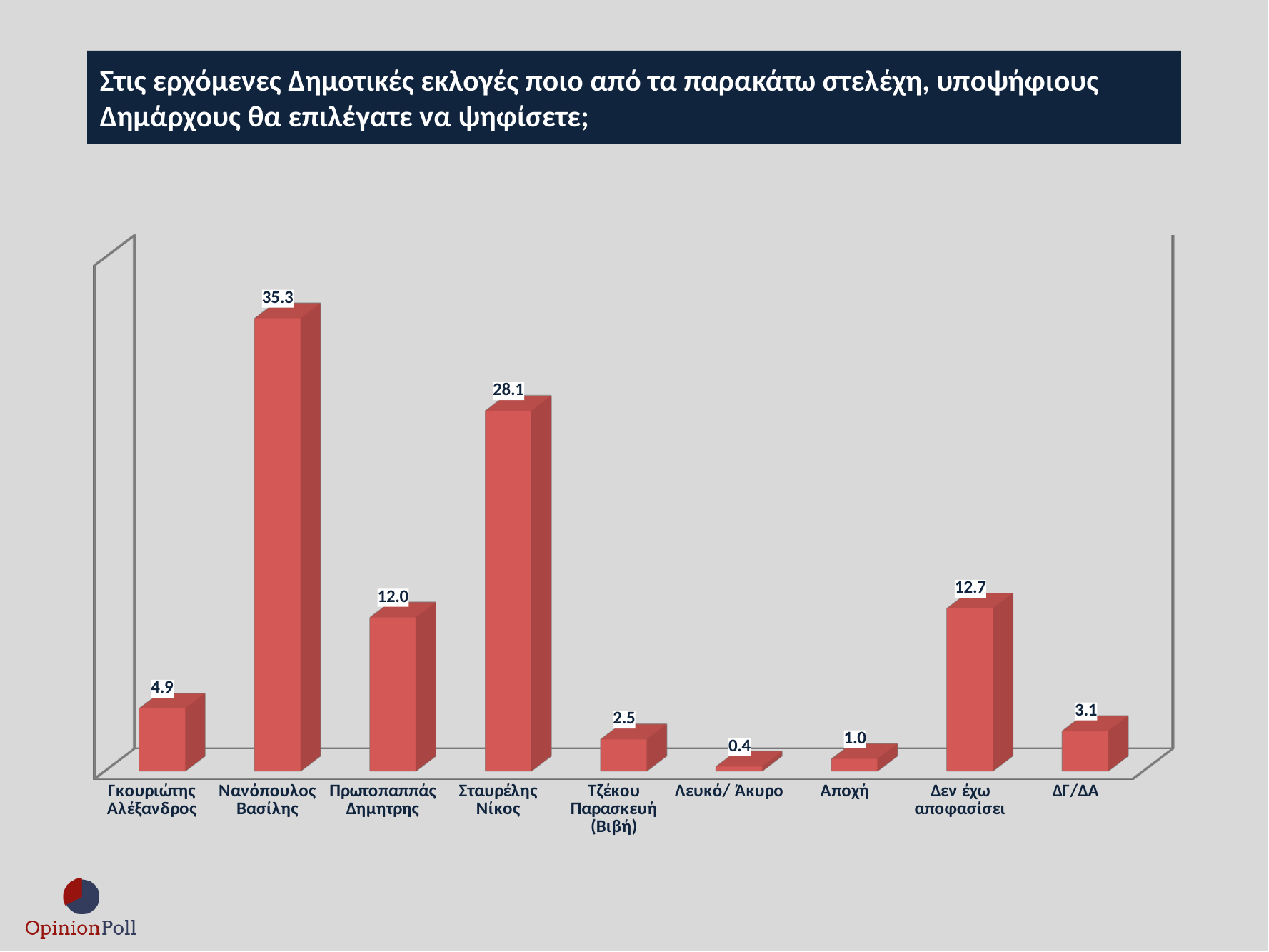
What is the value for Σταυρέλης Νίκος? 28.1 Which category has the highest value? Νανόπουλος Βασίλης What is the value for Νανόπουλος Βασίλης? 35.3 What is the difference between the values for Νανόπουλος Βασίλης and Σταυρέλης Νίκος? 7.2 What is the value for Δεν έχω αποφασίσει? 12.7 What kind of chart is shown on the slide? Bar chart What is the difference between the values for ΔΓ/ΔΑ and Τζέκου Παρασκευή (Βιβή)? 0.6 Which category has the lowest value? Λευκό/ Άκυρο What is the value for Γκουριώτης Αλέξανδρος? 4.9 Which is larger, the value for Πρωτοπαππάς Δημήτρης or the value for Δεν έχω αποφασίσει? Δεν έχω αποφασίσει What is the value for Λευκό/ Άκυρο? 0.4 How many categories are shown on the x axis? 9